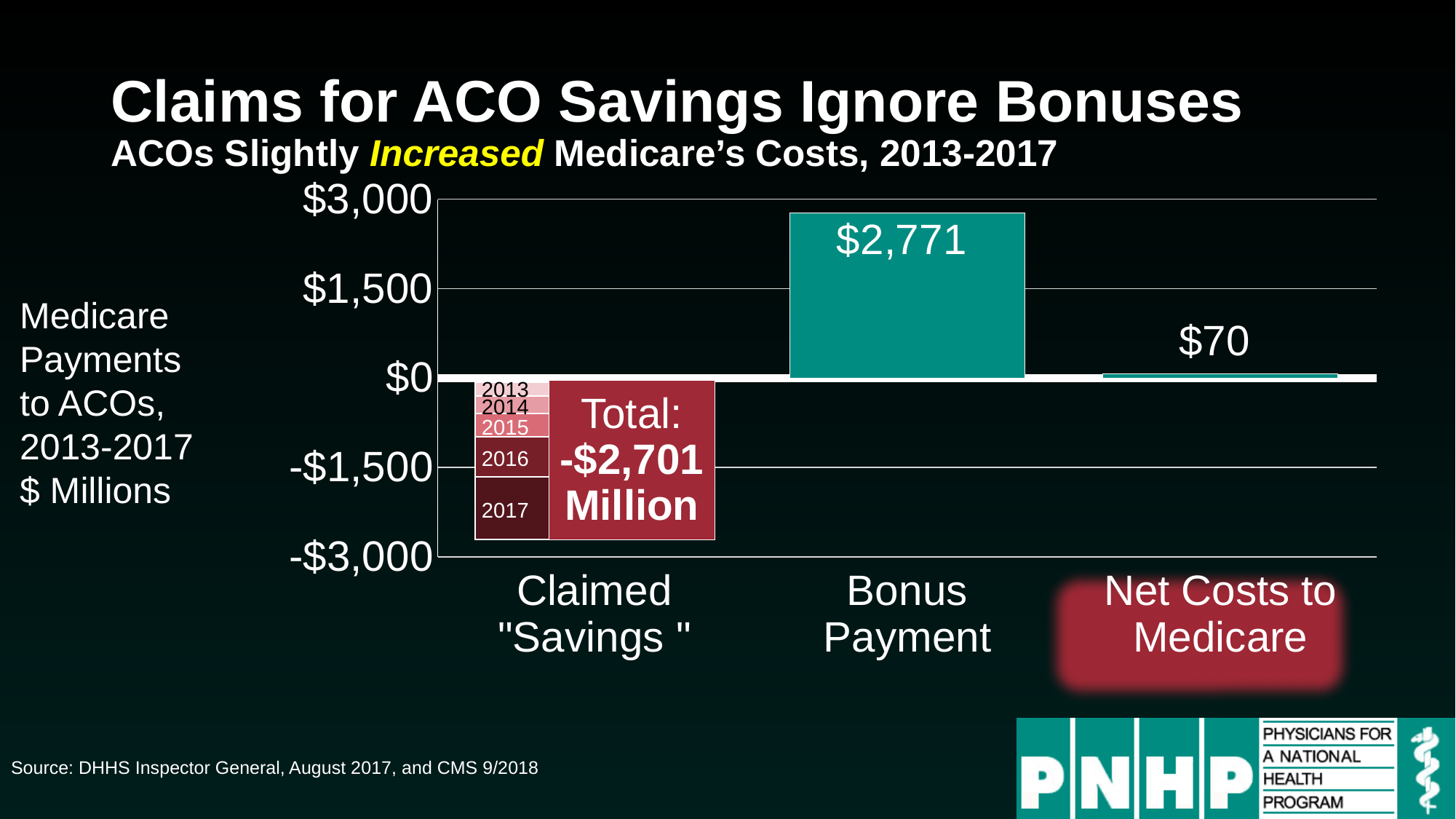
What is the highest value labelled on the y axis? $3,000 What is the difference between the Bonus Payment value and the Net Costs to Medicare value? $2,701 What is the value shown for Net Costs to Medicare? $70 What is the value shown for Bonus Payment? $2,771 Which category has the highest value? Bonus Payment Which is larger, the value for Bonus Payment or the value for Net Costs to Medicare? Bonus Payment How many categories are shown on the x axis? 3 How many years are labelled within the stacked Claimed "Savings" bar? 5 What kind of chart is shown on the slide? bar chart Is the value for Bonus Payment greater or less than $1,500? greater What total is printed on the Claimed "Savings" bar? -$2,701 Million Which category has the lowest value? Claimed "Savings"